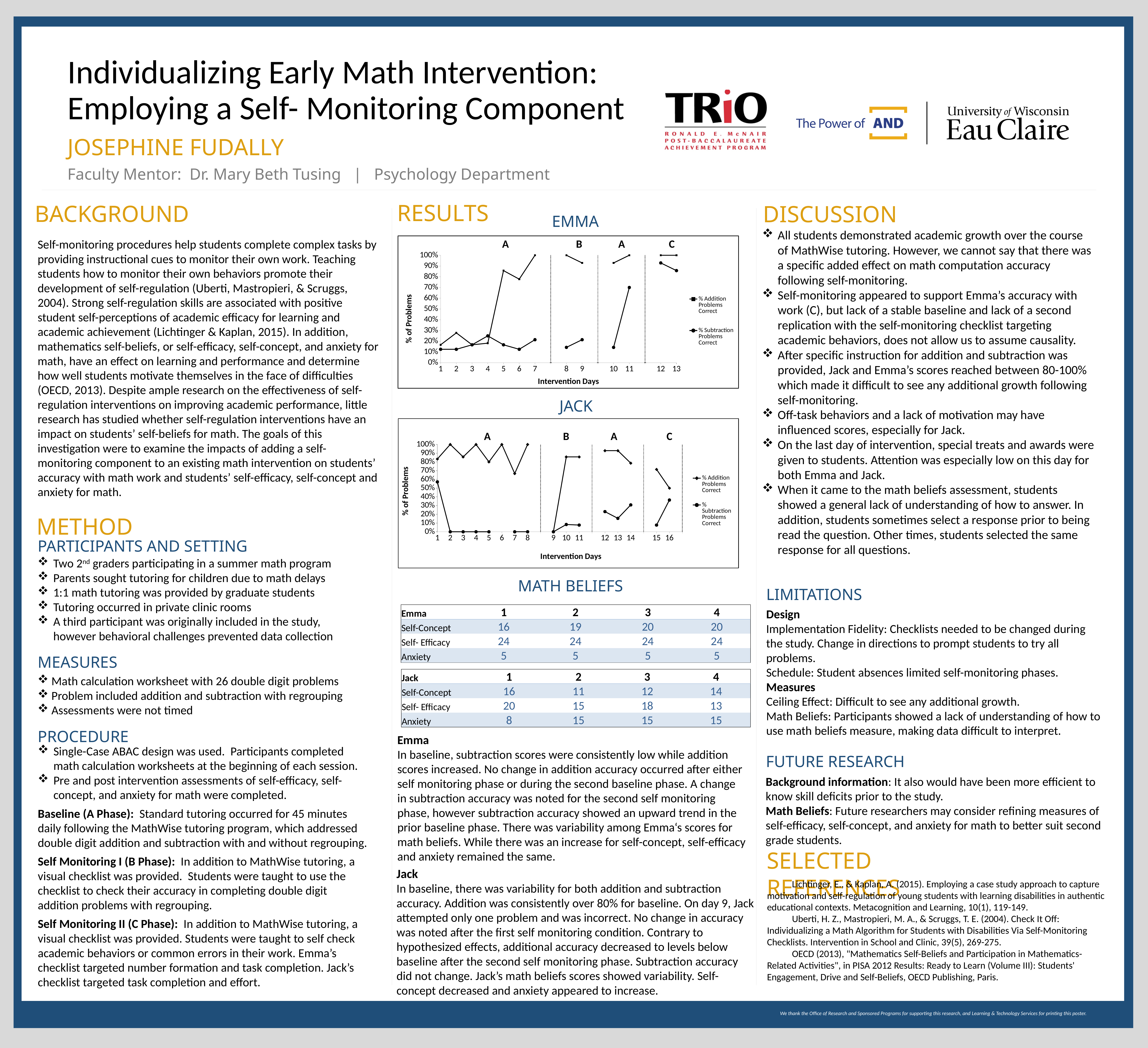
What is the x-axis title of the EMMA chart? Intervention Days In the JACK chart, is the % Subtraction Problems Correct value on day 1 greater or less than 40%? greater In the EMMA chart, on intervention day 7, which series has the larger value: % Addition Problems Correct or % Subtraction Problems Correct? % Addition Problems Correct In the JACK chart, what is the % Addition Problems Correct value on intervention day 9? 0% How many intervention days are shown on the x axis of the JACK chart? 16 What kind of chart is the EMMA chart? line chart In the JACK chart, what is the % Subtraction Problems Correct value on intervention day 2? 0% In the EMMA chart, is the % Subtraction Problems Correct value on day 1 greater or less than 20%? less How many intervention days are shown on the x axis of the EMMA chart? 13 In the EMMA chart, what is the % Addition Problems Correct value on intervention day 7? 100% How many series does the legend of the JACK chart list? 2 In the JACK chart, is the % Addition Problems Correct value on day 7 greater or less than 80%? less